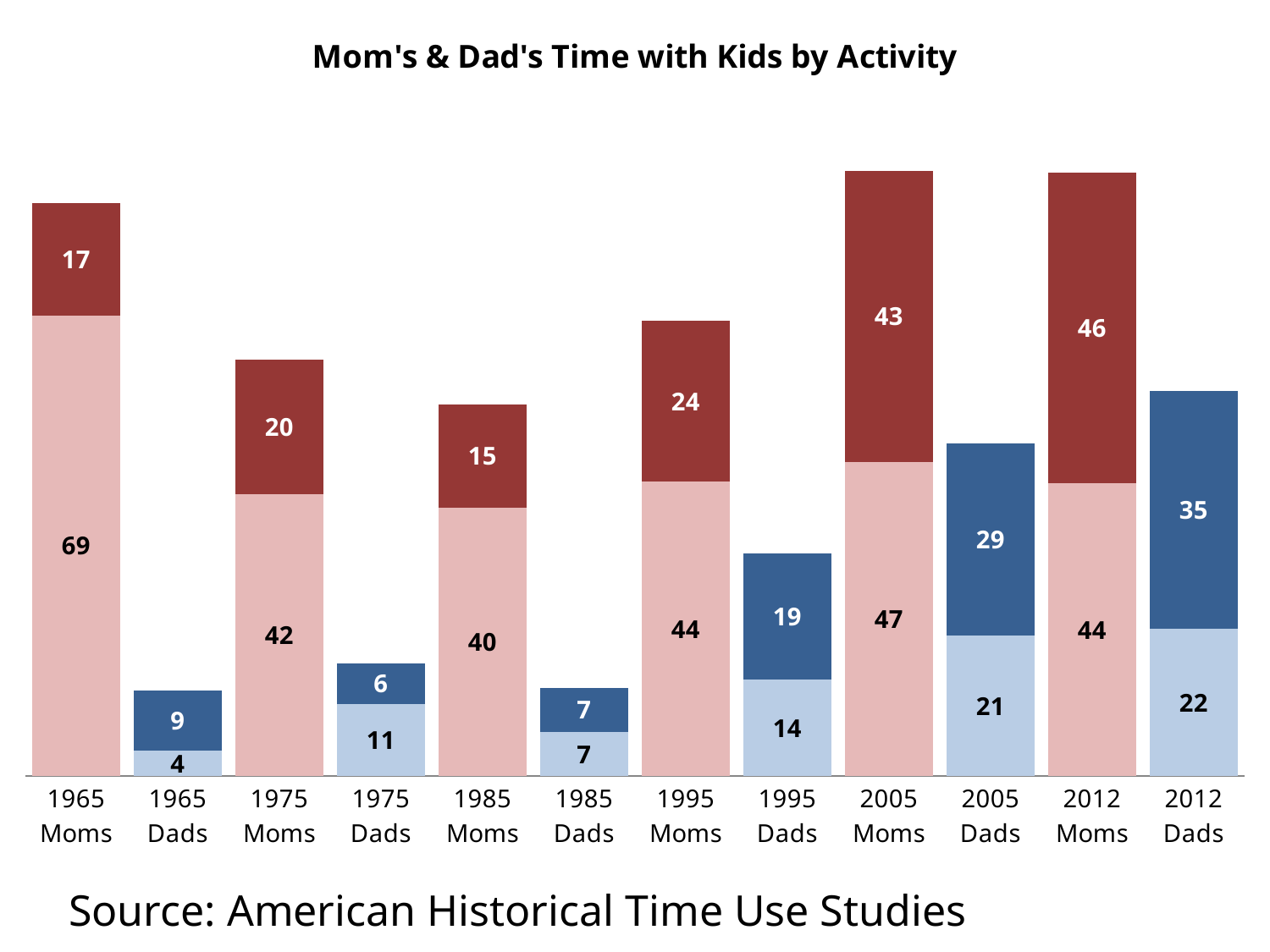
Which is larger, the total of the 1995 Moms bar or the total of the 1995 Dads bar? 1995 Moms What type of chart is shown on the slide? Stacked bar chart Which bar has the smallest bottom segment? 1965 Dads What is the value of the bottom segment of the 1965 Moms bar? 69 What is the value of the top segment of the 2005 Moms bar? 43 How many bars are plotted in the chart? 12 What is the difference between the top segment of the 2012 Moms bar and the top segment of the 2012 Dads bar? 11 What is the value of the top segment of the 2012 Dads bar? 35 What is the title of the chart? Mom's & Dad's Time with Kids by Activity Which bar has the largest bottom segment? 1965 Moms What is the total of the 2005 Dads stacked bar? 50 What is the total of the 1965 Moms stacked bar? 86